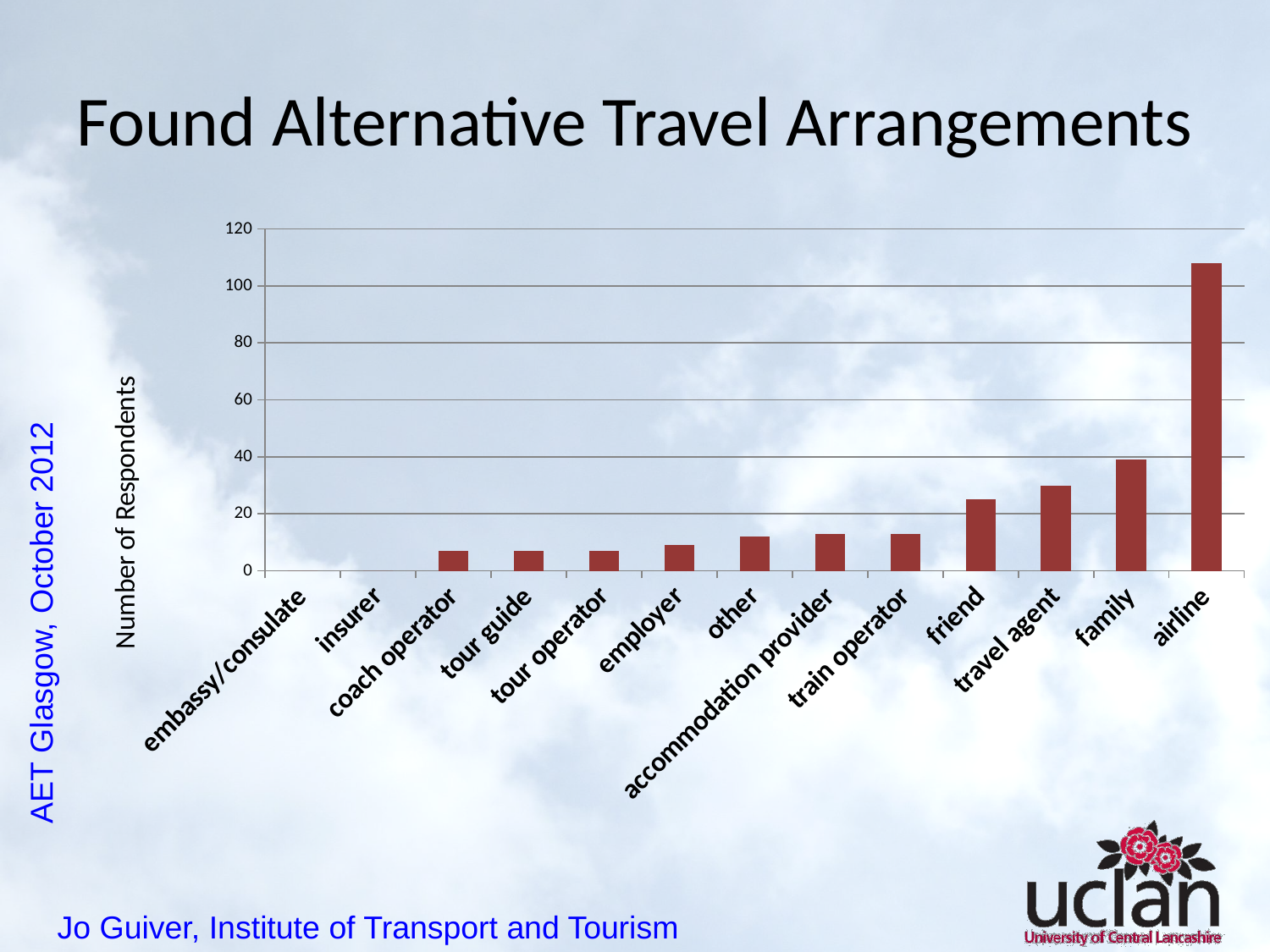
What kind of chart is shown on the slide? bar chart Is the value for travel agent greater or less than 40? less Which is larger, the value for family or the value for travel agent? family Is the value for coach operator greater or less than 20? less Is the value for airline greater or less than 100? greater Which is larger, the value for friend or the value for other? friend How many categories are shown on the x axis? 13 Do the values generally rise or fall moving from left to right along the x axis? rise What is the label on the vertical axis? Number of Respondents Which category has the highest number of respondents? airline